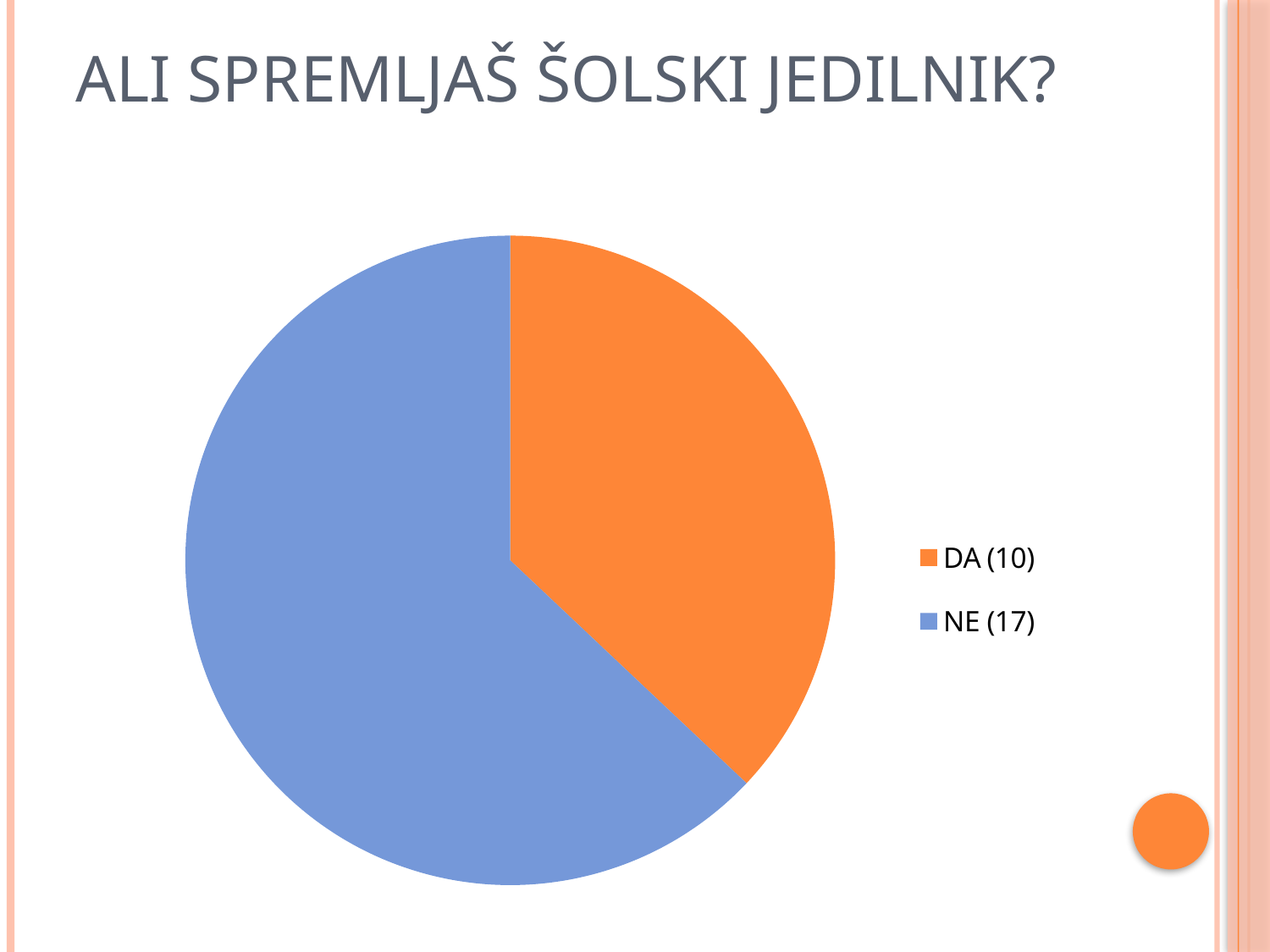
Which category has the smallest slice? DA Which is larger, the value for DA or the value for NE? NE Which category has the largest slice? NE How many slices does the pie chart have? 2 What is the title of the slide? ALI SPREMLJAŠ ŠOLSKI JEDILNIK? What colour is the DA slice? orange What is the total of the values for DA and NE? 27 What is the value for NE? 17 What is the value for DA? 10 What is the difference between the values for NE and DA? 7 What kind of chart is shown on the slide? pie chart How many entries does the legend list? 2